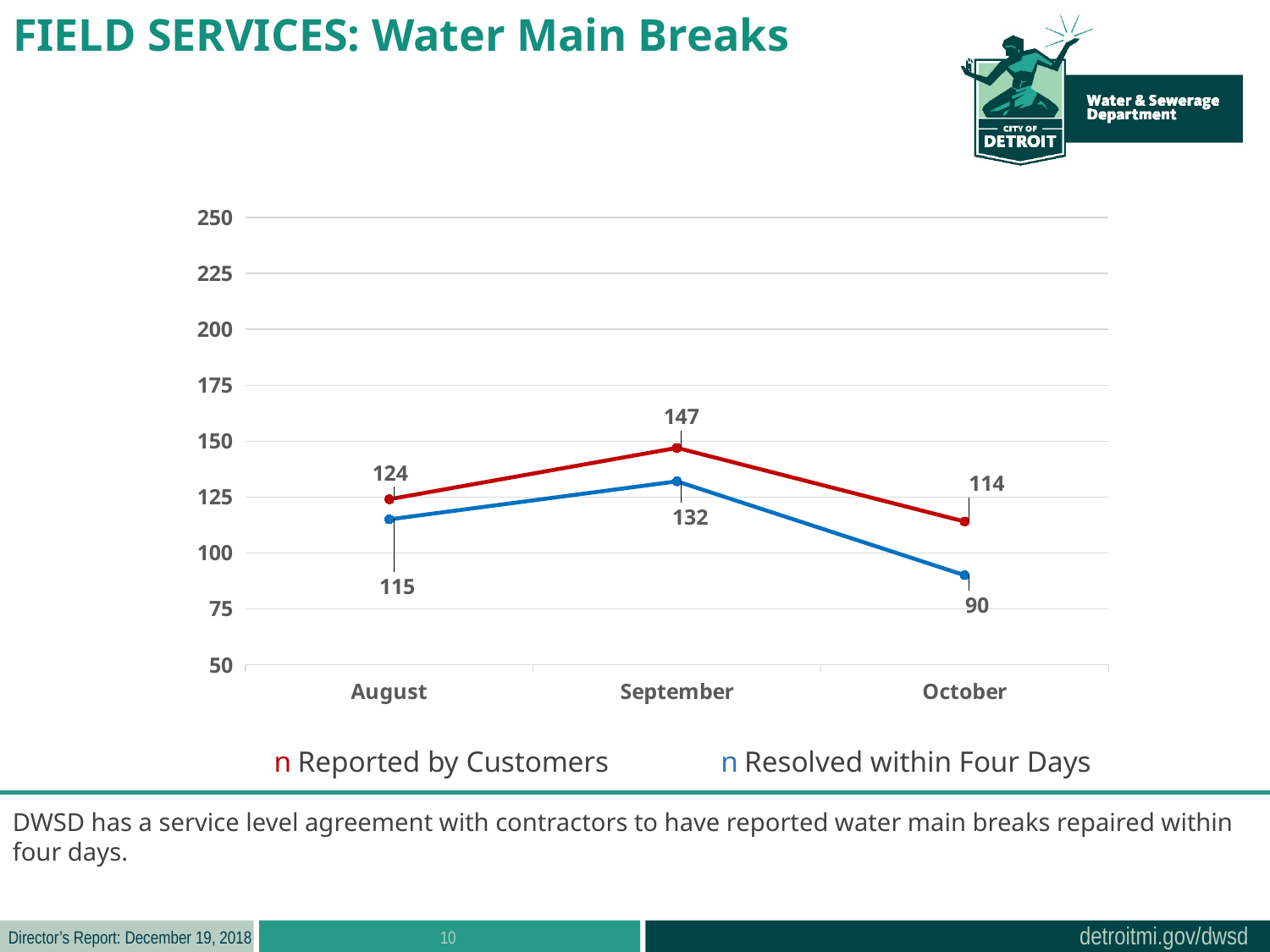
Which is larger in September: Reported by Customers or Resolved within Four Days? Reported by Customers What kind of chart is shown? line chart How many months are shown on the x axis? 3 In which month is Reported by Customers highest? September What is the value for Resolved within Four Days in October? 90 How many series does the legend list? 2 What is the difference between Reported by Customers and Resolved within Four Days in October? 24 In which month is Resolved within Four Days lowest? October What is the value for Reported by Customers in August? 124 Is the value for Resolved within Four Days in August greater or less than 100? greater What is the value for Reported by Customers in September? 147 Does Resolved within Four Days rise or fall from September to October? fall